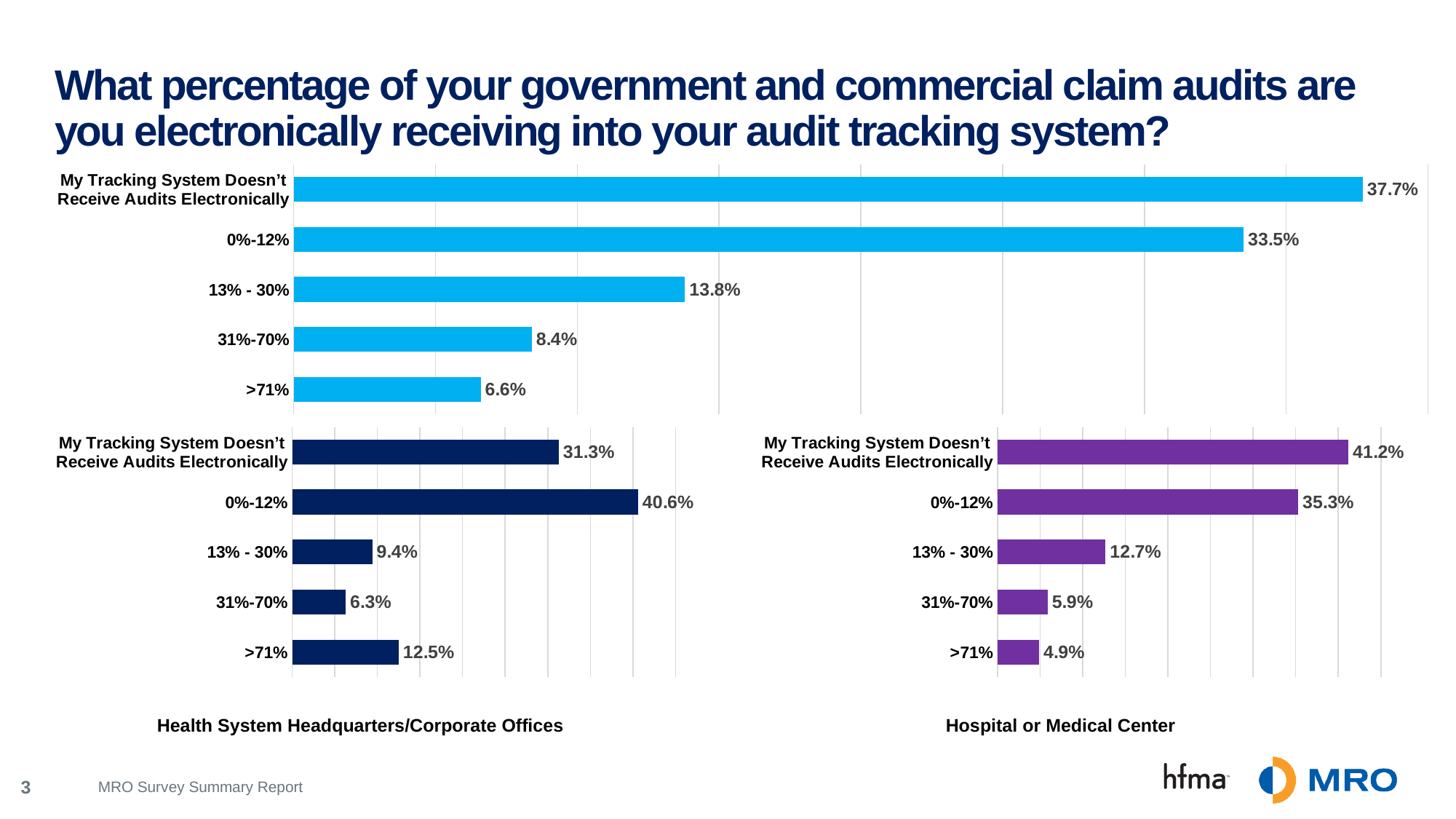
In the Health System Headquarters/Corporate Offices chart, which is larger: the value for >71% or the value for 31%-70%? >71% What colour are the bars in the Hospital or Medical Center chart? Purple In the Hospital or Medical Center chart, what is the difference between the values for "My Tracking System Doesn't Receive Audits Electronically" and 0%-12%? 5.9% In the top chart, what is the value for "My Tracking System Doesn't Receive Audits Electronically"? 37.7% In the top chart, which category has the lowest value? >71% In the Hospital or Medical Center chart, which category has the lowest value? >71% In the Health System Headquarters/Corporate Offices chart, what is the value for 0%-12%? 40.6% In the top chart, what is the difference between the values for 0%-12% and 13% - 30%? 19.7% In the Hospital or Medical Center chart, what is the value for 13% - 30%? 12.7% In the Health System Headquarters/Corporate Offices chart, which category has the highest value? 0%-12% How many categories does the Hospital or Medical Center chart show? 5 What kind of chart is the top chart? Bar chart